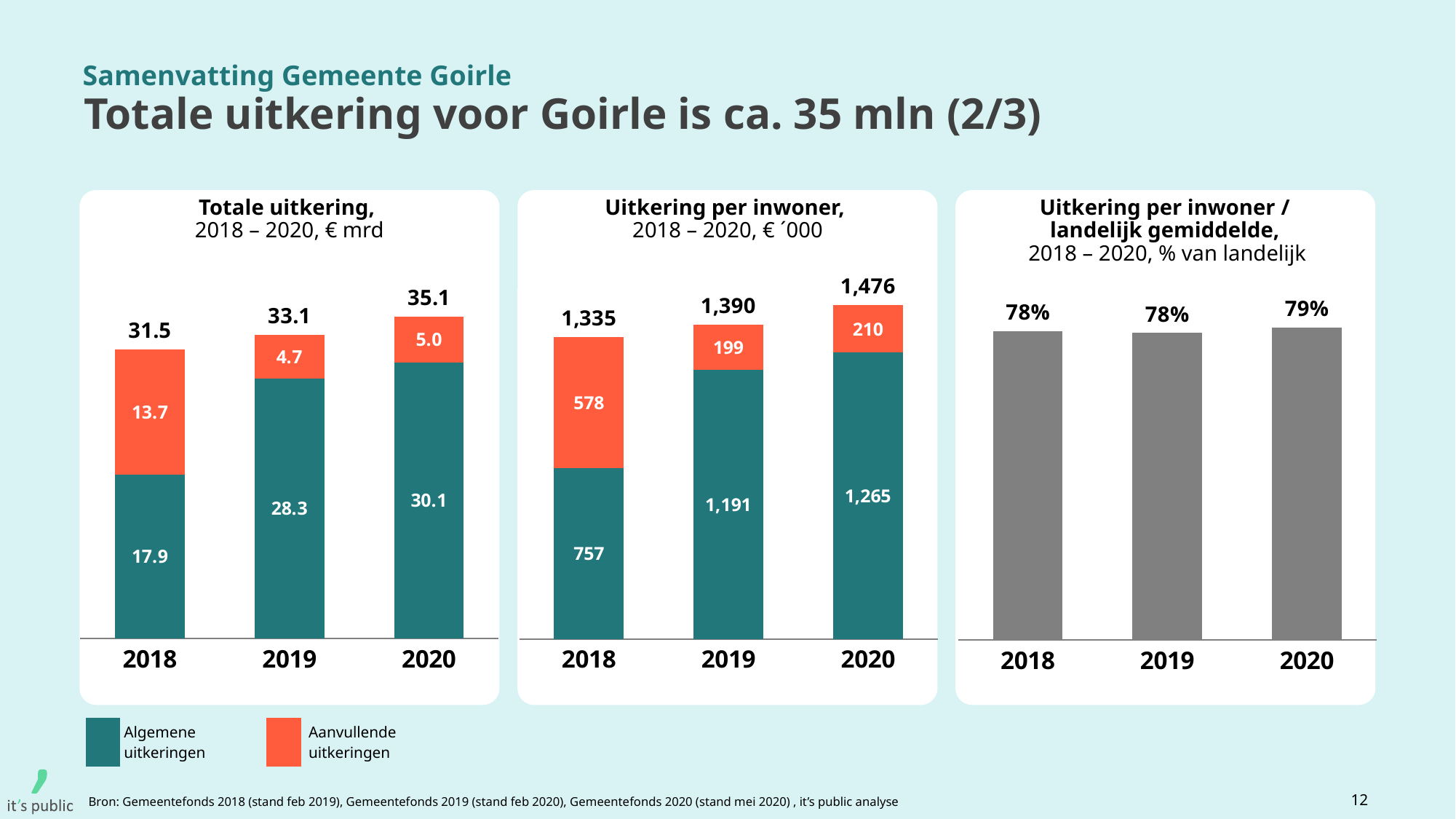
In the 'Uitkering per inwoner / landelijk gemiddelde' chart, how many years are shown? 3 In the 'Uitkering per inwoner' chart, what is the value of Algemene uitkeringen for 2019? 1,191 In the 'Uitkering per inwoner' chart, is the Aanvullende uitkeringen value larger in 2018 or in 2020? 2018 In the 'Totale uitkering' chart, what is the value of Algemene uitkeringen for 2018? 17.9 In the 'Totale uitkering' chart, what is the difference between the Aanvullende uitkeringen values for 2018 and 2020? 8.7 How many series does the legend at the bottom of the slide list? 2 In the 'Totale uitkering' chart, what is the total of the stacked bar for 2020? 35.1 In the 'Totale uitkering' chart, what is the value of Aanvullende uitkeringen for 2019? 4.7 In the 'Uitkering per inwoner / landelijk gemiddelde' chart, what is the value for 2020? 79% In the 'Uitkering per inwoner' chart, what is the total of the stacked bar for 2018? 1,335 In the 'Uitkering per inwoner' chart, which year has the highest total? 2020 Do the totals in the 'Totale uitkering' chart rise or fall from 2018 to 2020? rise